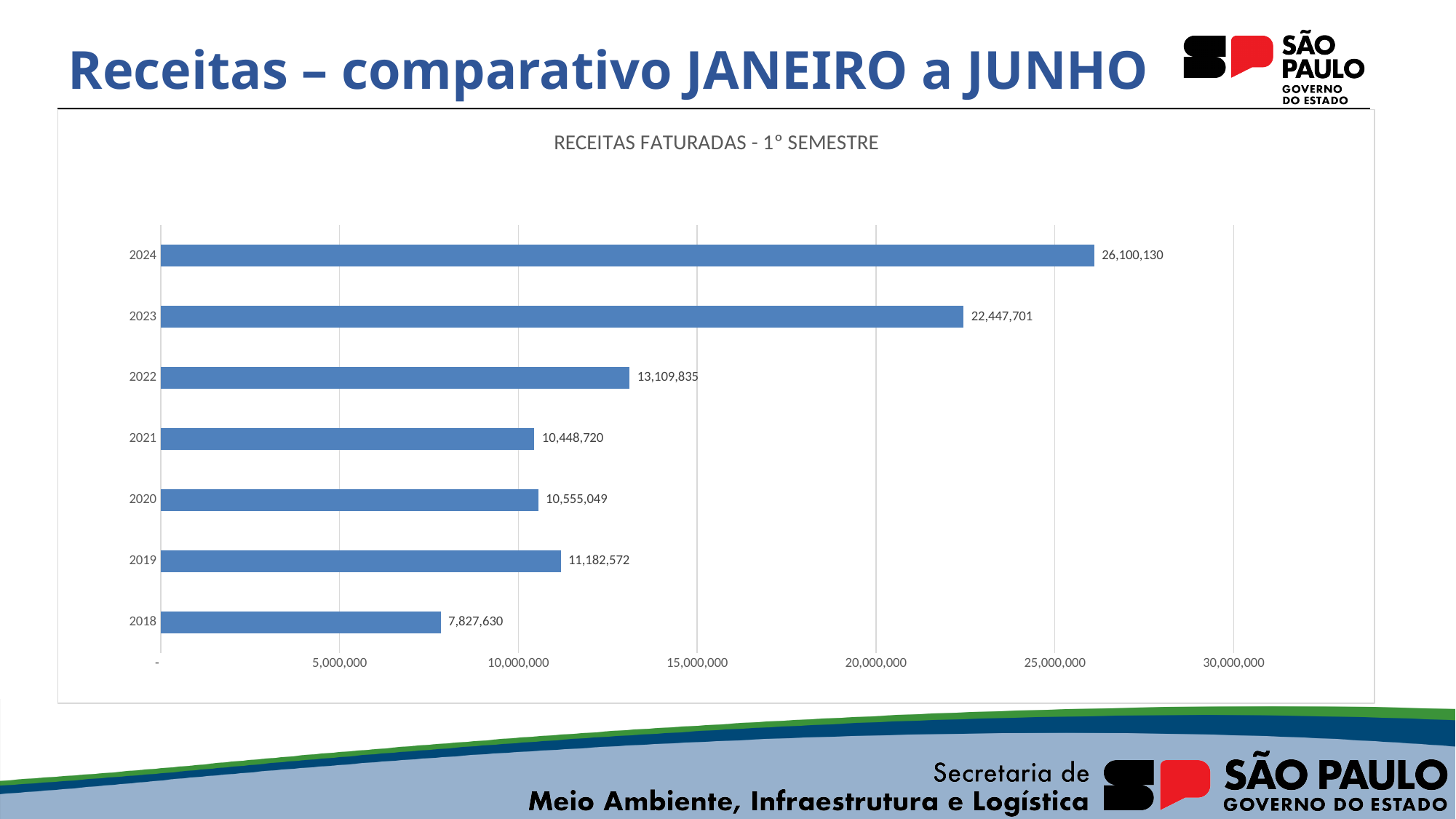
Which year has the lowest value? 2018 What is the difference between the values for 2019 and 2018? 3,354,942 Which is larger, the value for 2022 or the value for 2019? 2022 What kind of chart is shown on the slide? bar chart How many years are shown in the chart? 7 What is the title of the chart? RECEITAS FATURADAS - 1° SEMESTRE Which year has the highest value? 2024 What is the value for 2024? 26,100,130 Is the value for 2023 greater or less than 20,000,000? greater What is the difference between the values for 2024 and 2023? 3,652,429 What is the value for 2022? 13,109,835 What is the value for 2018? 7,827,630